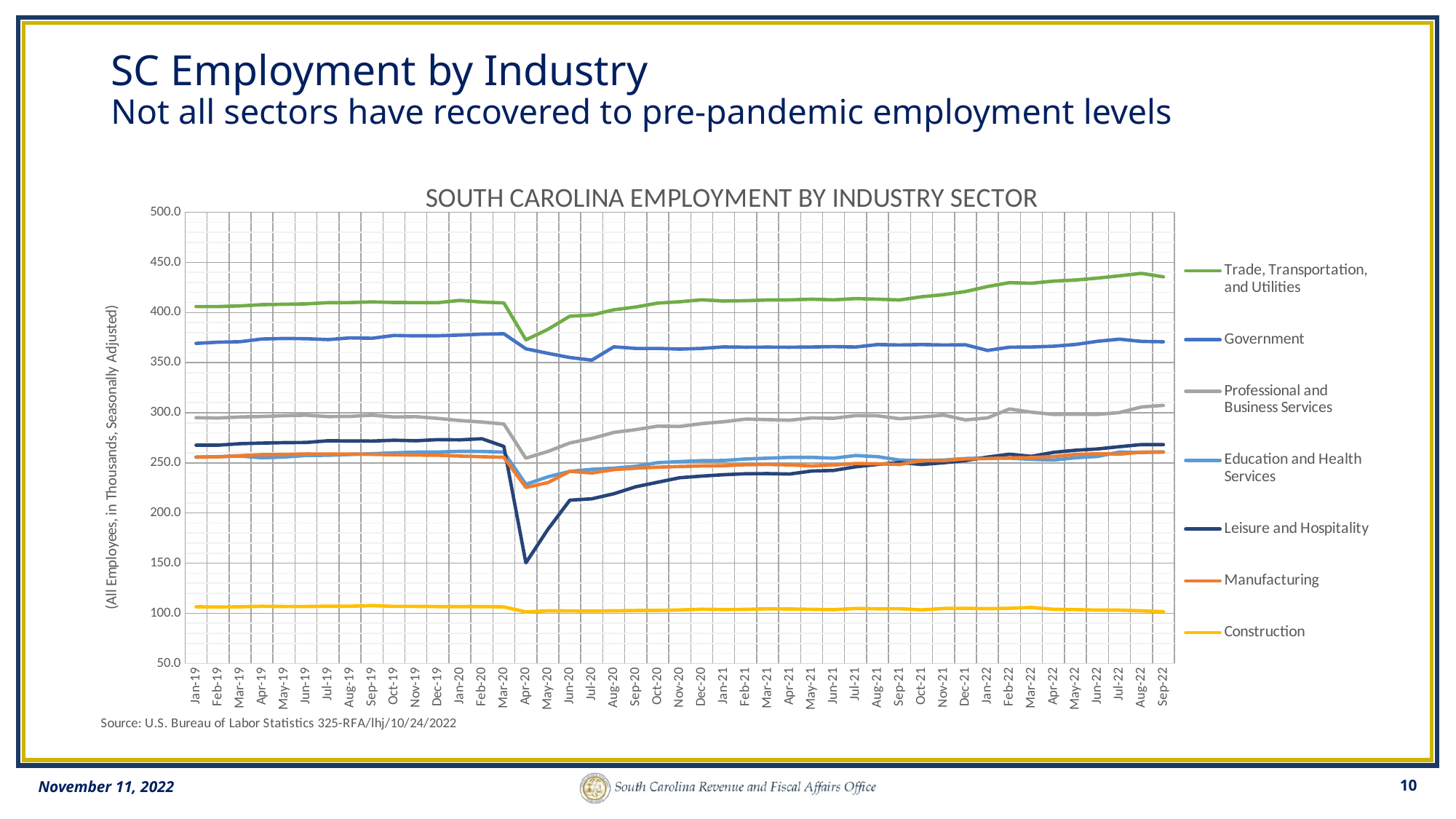
Is the value for Leisure and Hospitality in Apr-20 greater or less than 200.0? less Which industry sector has the lowest employment throughout the chart? Construction What is the title of the chart? SOUTH CAROLINA EMPLOYMENT BY INDUSTRY SECTOR Is the value for Manufacturing in Apr-20 greater or less than 250.0? less How many series does the legend of the chart list? 7 How many monthly points are shown on the x axis, from Jan-19 to Sep-22? 45 What kind of chart is shown on the slide? line chart What is the label on the vertical axis of the chart? (All Employees, in Thousands, Seasonally Adjusted) Which industry sector has the highest employment throughout the chart? Trade, Transportation, and Utilities Does the Trade, Transportation, and Utilities line rise or fall from Jan-21 to Sep-22? rise In Jan-19, which is larger: Government or Professional and Business Services? Government Is the value for Trade, Transportation, and Utilities in Sep-22 greater or less than 400.0? greater